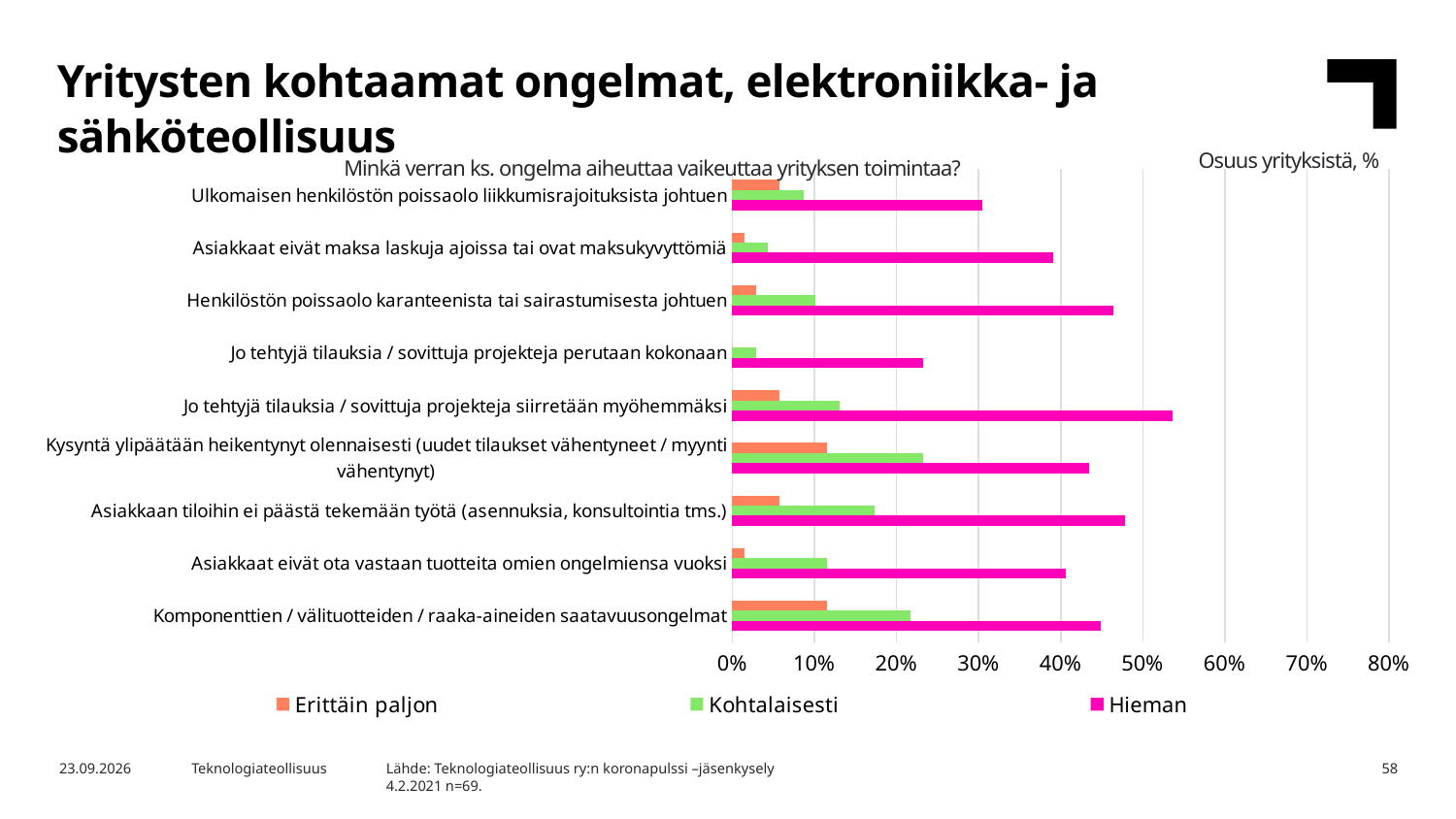
Is the 'Hieman' value for 'Jo tehtyjä tilauksia / sovittuja projekteja siirretään myöhemmäksi' greater or less than 50%? greater Is the 'Kohtalaisesti' value for 'Kysyntä ylipäätään heikentynyt olennaisesti' greater or less than 20%? greater What are the three series named in the legend? Erittäin paljon, Kohtalaisesti, Hieman How many problem categories are plotted on the chart? 9 Is the 'Hieman' value for 'Jo tehtyjä tilauksia / sovittuja projekteja perutaan kokonaan' greater or less than 30%? less Which category has the highest value for the 'Hieman' series? Jo tehtyjä tilauksia / sovittuja projekteja siirretään myöhemmäksi For the 'Kohtalaisesti' series, which is larger: 'Asiakkaan tiloihin ei päästä tekemään työtä' or 'Ulkomaisen henkilöstön poissaolo liikkumisrajoituksista johtuen'? Asiakkaan tiloihin ei päästä tekemään työtä What kind of chart is shown on the slide? Bar chart For the 'Hieman' series, which is larger: 'Asiakkaat eivät maksa laskuja ajoissa tai ovat maksukyvyttömiä' or 'Komponenttien / välituotteiden / raaka-aineiden saatavuusongelmat'? Komponenttien / välituotteiden / raaka-aineiden saatavuusongelmat How many series does the legend list? 3 Which category has the lowest value for the 'Hieman' series? Jo tehtyjä tilauksia / sovittuja projekteja perutaan kokonaan